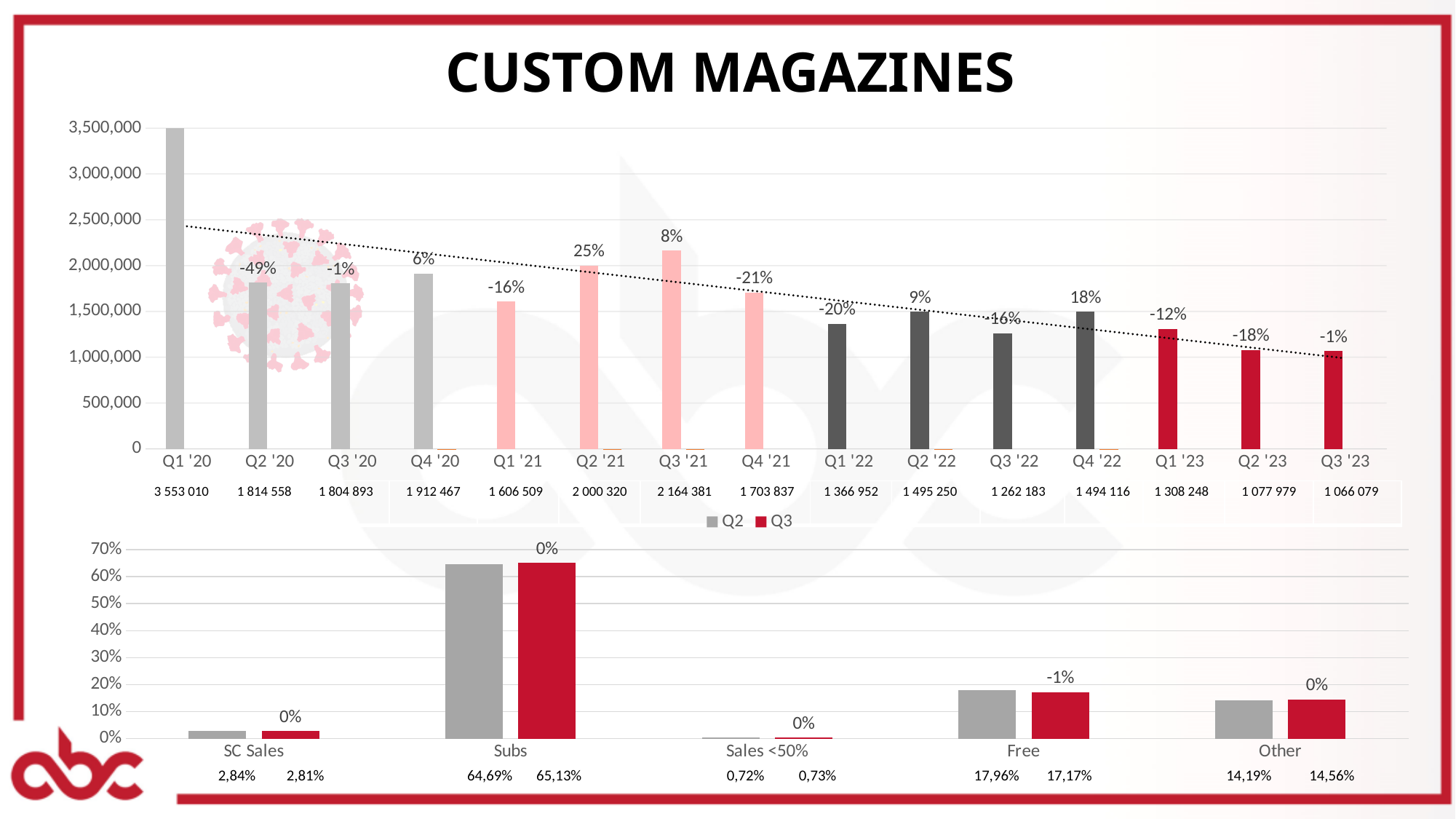
In the top chart, is the value for Q2 '21 greater or less than 1,500,000? greater In the top chart, what percentage change is labelled above the Q2 '20 bar? -49% In the bottom chart, what is the Q3 value for Subs? 65,13% In the top chart, how many quarters are plotted? 15 In the top chart, what is the value for Q3 '21? 2 164 381 In the bottom chart, how many series does the legend list? 2 In the top chart, which quarter has the lowest value? Q3 '23 In the top chart, which quarter has the highest value? Q1 '20 In the top chart, what is the difference between the values for Q2 '23 and Q3 '23? 11 900 In the bottom chart, what is the difference between the Q2 and Q3 values for Free? 0,79% In the bottom chart, which category has the lowest values? Sales <50% In the top chart, what is the value for Q1 '20? 3 553 010